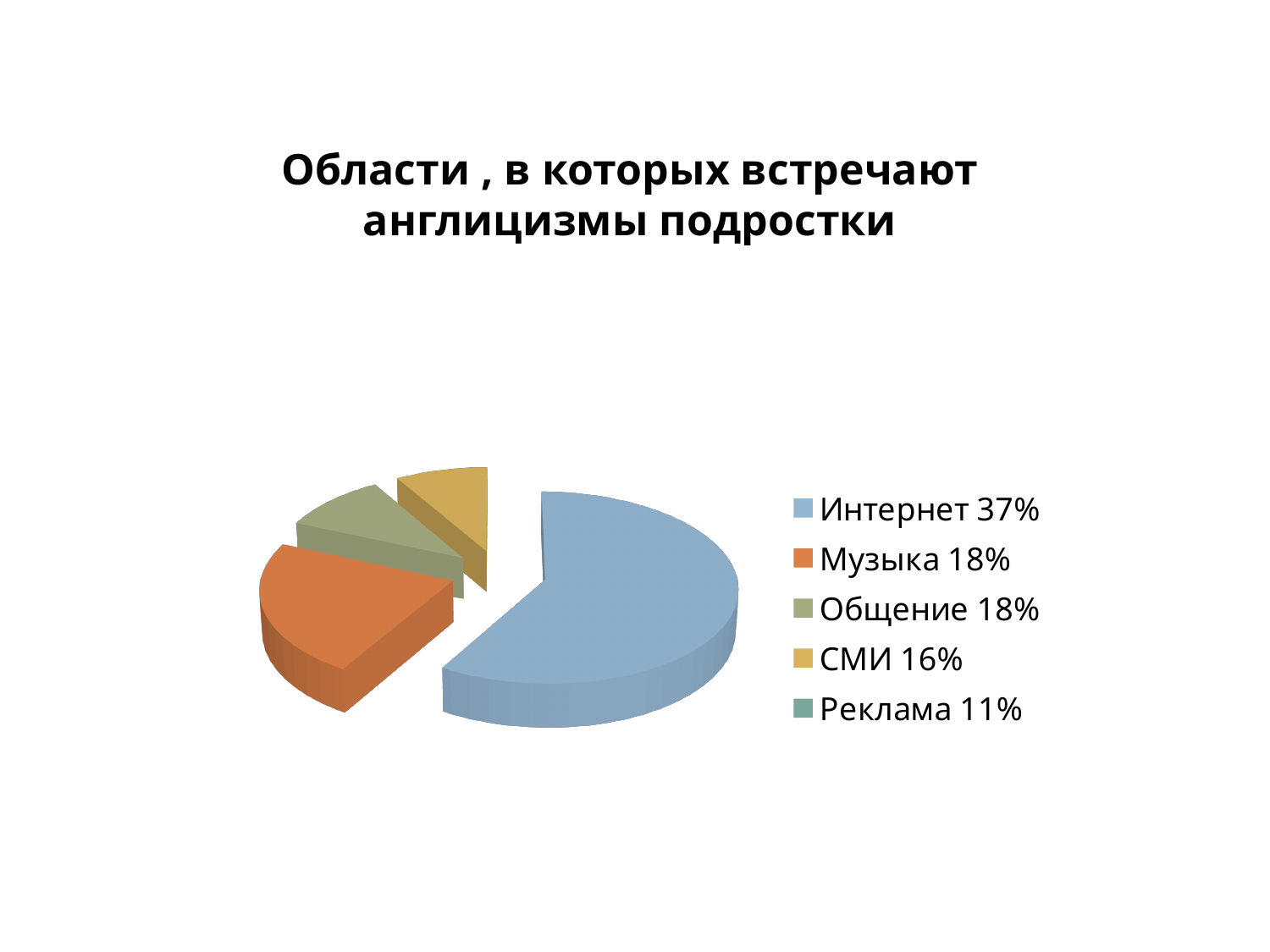
How many categories does the legend list? 5 Which category has the largest share? Интернет What is the difference in percentage points between Интернет and Музыка? 19 What is the difference in percentage points between СМИ and Реклама? 5 What kind of chart is shown on the slide? pie chart What percentage is shown for Музыка? 18% What percentage is shown for Реклама? 11% What percentage is shown for СМИ? 16% What percentage is shown for Интернет? 37% Which category has the smallest share? Реклама Which is larger, the share for Общение or the share for СМИ? Общение What is the title of the chart? Области , в которых встречают англицизмы подростки